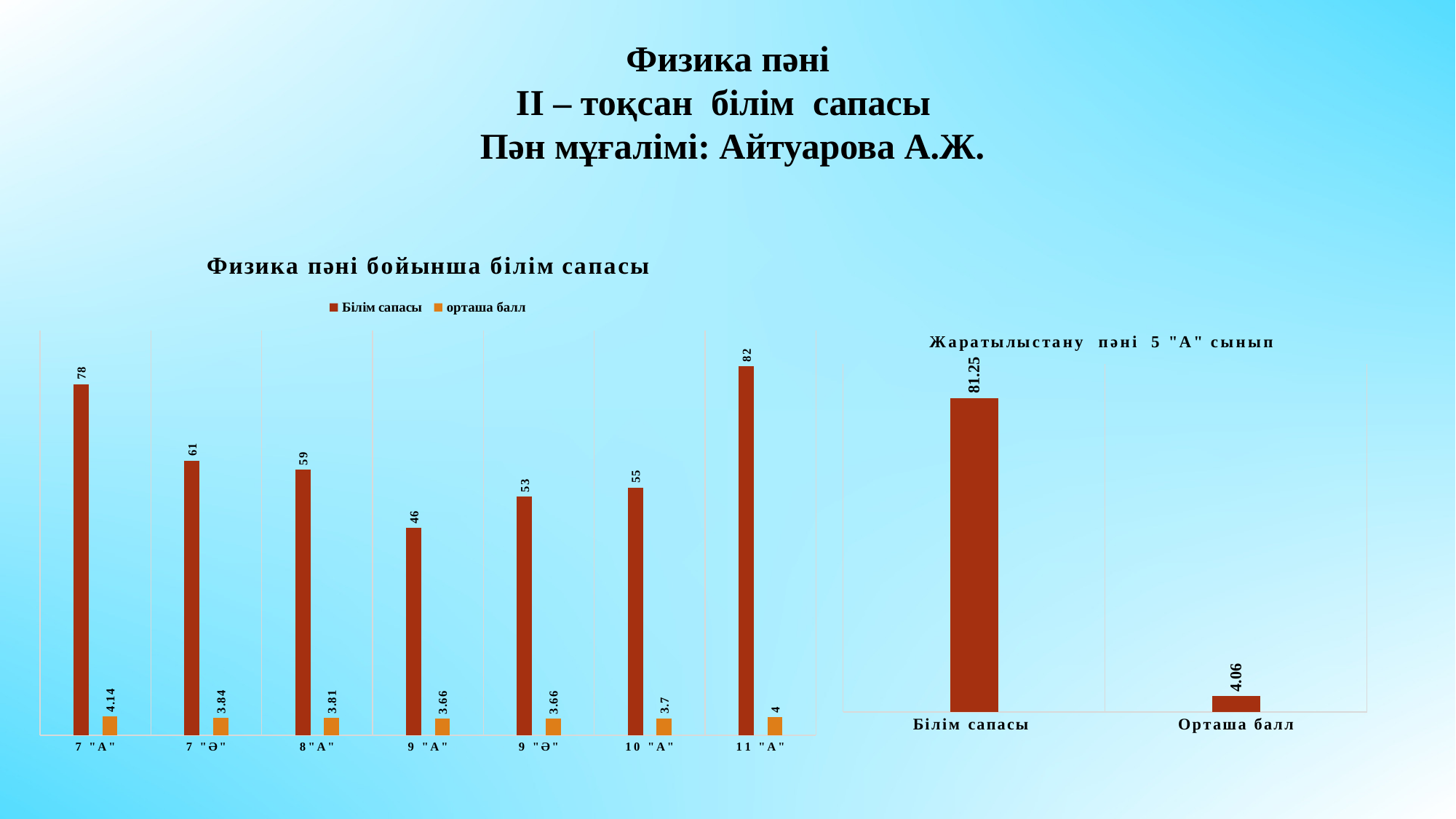
What kind of chart is "Физика пәні бойынша білім сапасы"? bar chart In the chart "Физика пәні бойынша білім сапасы", what is the орташа балл value for 10 "А"? 3.7 In the chart "Физика пәні бойынша білім сапасы", what is the difference between the Білім сапасы values for 7 "А" and 7 "Ә"? 17 In the chart "Физика пәні бойынша білім сапасы", how many series does the legend list? 2 In the chart "Физика пәні бойынша білім сапасы", what is the орташа балл value for 7 "А"? 4.14 In the chart "Физика пәні бойынша білім сапасы", which class has the lowest Білім сапасы value? 9 "А" In the chart "Жаратылыстану пәні 5 "А" сынып", what is the value for Орташа балл? 4.06 In the chart "Физика пәні бойынша білім сапасы", what is the Білім сапасы value for 11 "А"? 82 In the chart "Жаратылыстану пәні 5 "А" сынып", what is the value for Білім сапасы? 81.25 In the chart "Физика пәні бойынша білім сапасы", how many classes are shown on the x axis? 7 In the chart "Физика пәні бойынша білім сапасы", which class has the highest Білім сапасы value? 11 "А" In the chart "Физика пәні бойынша білім сапасы", which is larger, the Білім сапасы value for 9 "Ә" or for 10 "А"? 10 "А"